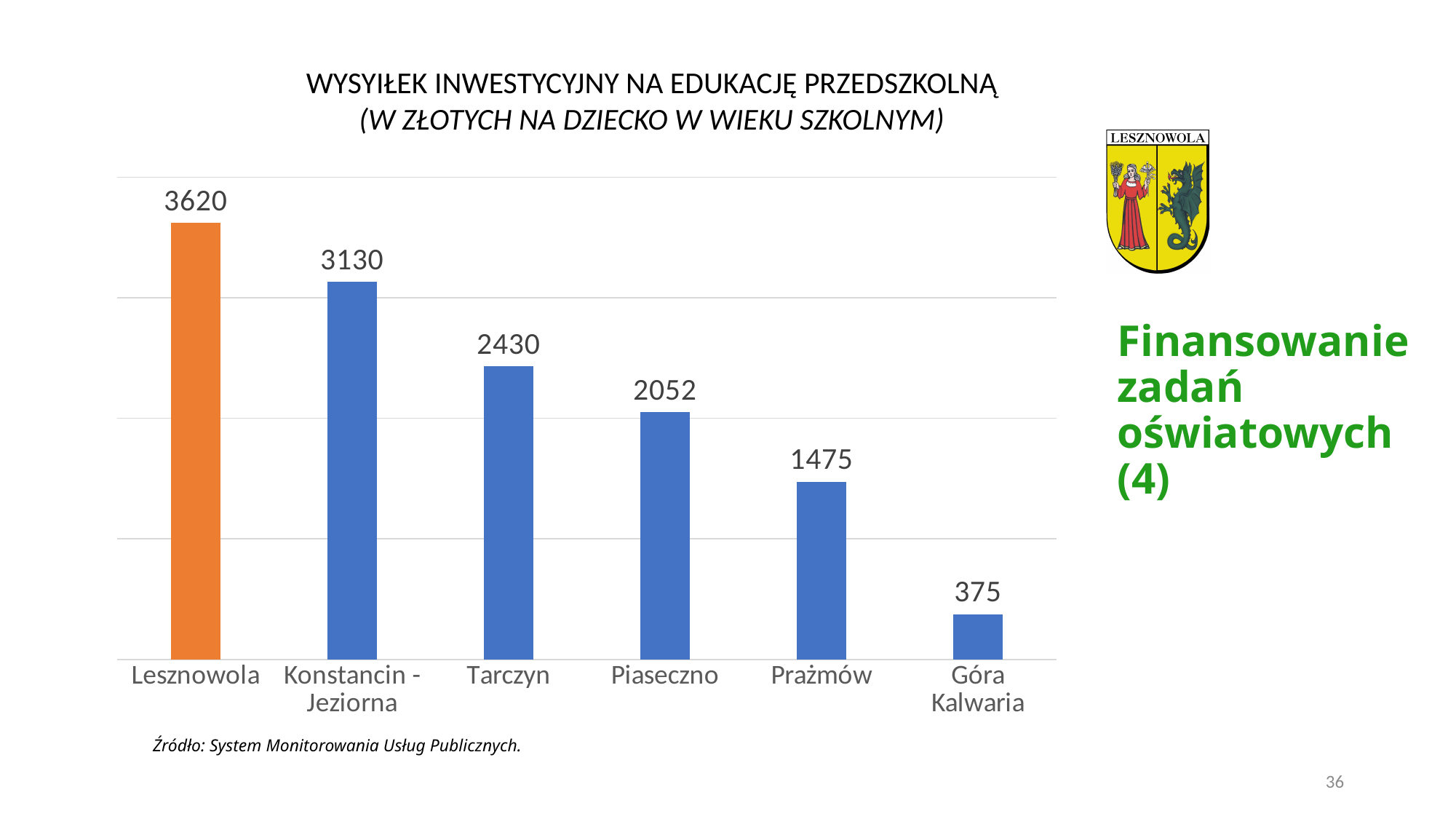
What is the value for Konstancin - Jeziorna? 3130 What is the value for Tarczyn? 2430 What is the value for Góra Kalwaria? 375 What is the value for Piaseczno? 2052 What is the difference between the values for Lesznowola and Konstancin - Jeziorna? 490 Which category has the lowest value? Góra Kalwaria Which category has the highest value? Lesznowola What is the value for Lesznowola? 3620 How many categories are shown in the chart? 6 What is the value for Prażmów? 1475 Which is larger, the value for Tarczyn or the value for Piaseczno? Tarczyn What kind of chart is shown on the slide? Bar chart